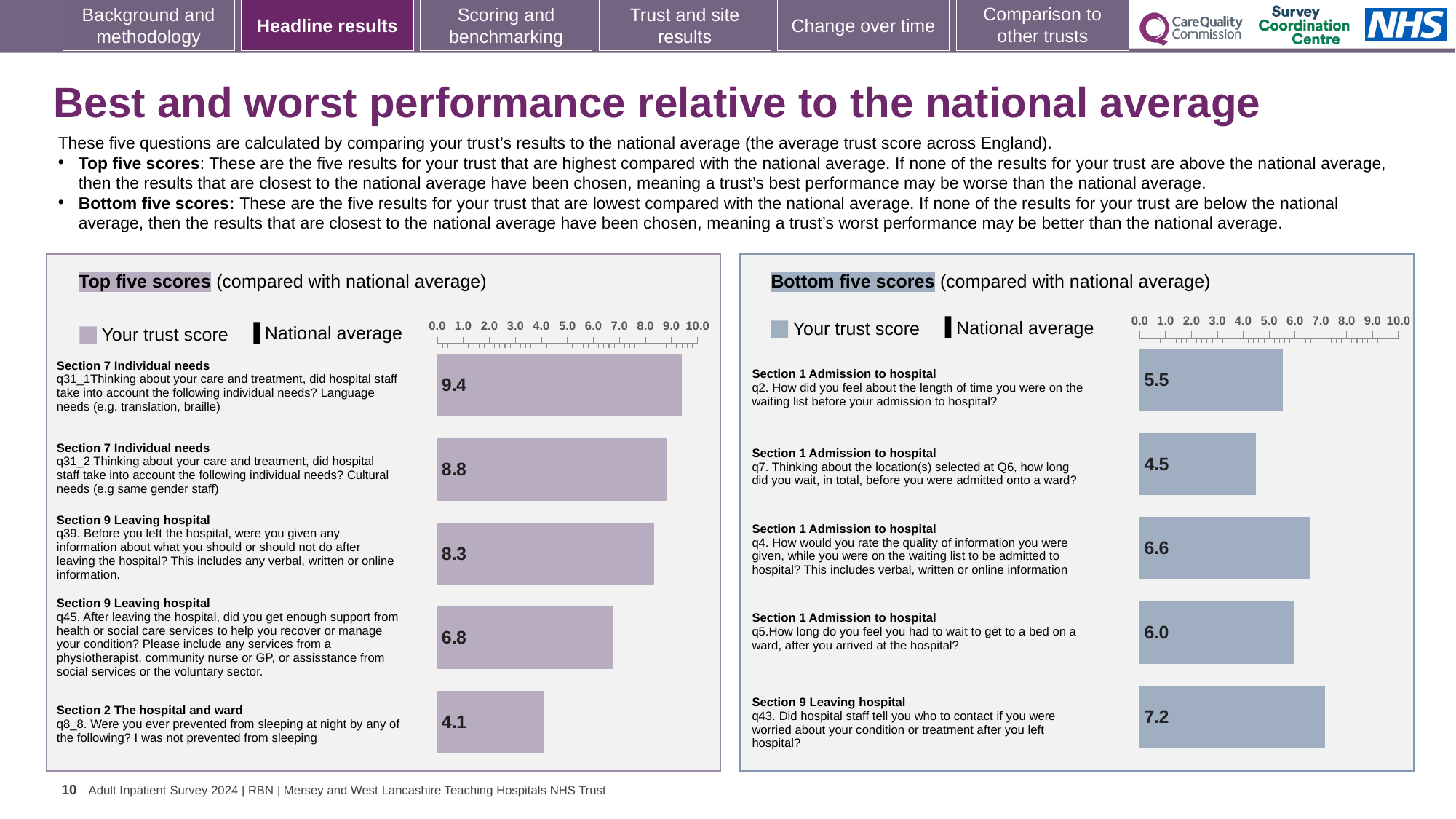
What type of chart is the Bottom five scores chart? Bar chart In the Bottom five scores chart, what is the trust score for q43 (told who to contact if worried after leaving hospital)? 7.2 In the Top five scores chart, what is the trust score for q45 (support from health or social care services after leaving hospital)? 6.8 In the Bottom five scores chart, what is the difference between the trust scores for q4 and q5? 0.6 In the Bottom five scores chart, what is the trust score for q7 (how long did you wait before being admitted onto a ward)? 4.5 In the Top five scores chart, what is the trust score for q31_1 (Language needs)? 9.4 In the Top five scores chart, what is the difference between the trust scores for q31_1 and q31_2? 0.6 In the Bottom five scores chart, which question has the highest trust score? q43 In the Bottom five scores chart, which has the larger trust score, q2 or q4? q4 How many bars are plotted in the Top five scores chart? 5 In the Bottom five scores chart, which question has the lowest trust score? q7 In the Top five scores chart, which question has the lowest trust score? q8_8 (I was not prevented from sleeping)